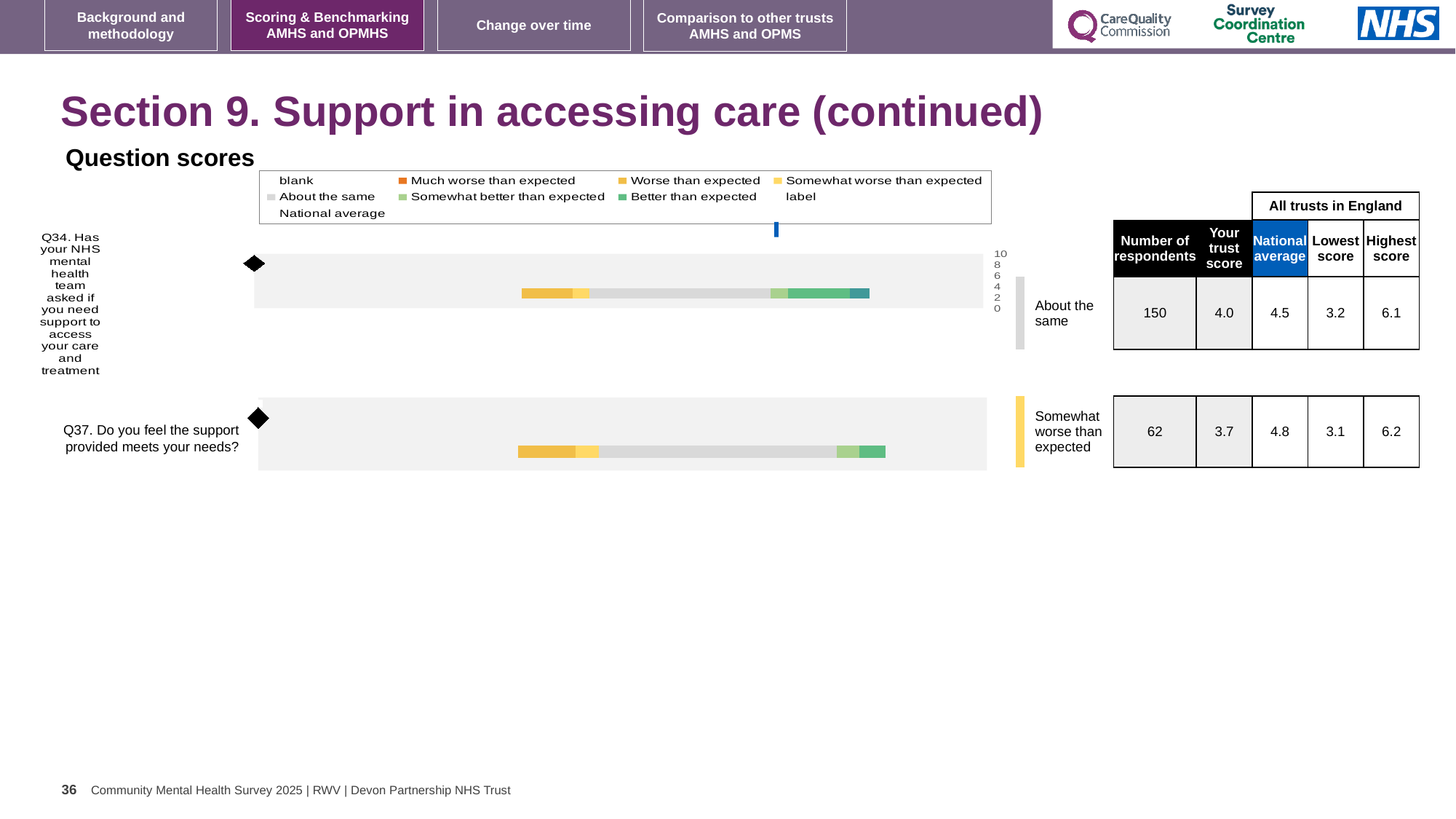
What benchmark category is shown for Q37? Somewhat worse than expected What benchmark category is shown for Q34? About the same What is the lowest score among all trusts in England for Q34? 3.2 Which question has the higher trust score, Q34 or Q37? Q34 What is the highest score among all trusts in England for Q37? 6.2 What is the difference between the national average and the trust score for Q34? 0.5 What kind of chart is used to show the question scores on this slide? bar chart How many questions are plotted in the question scores chart? 2 What is the trust score for Q37 (Do you feel the support provided meets your needs?)? 3.7 What is the number of respondents for Q34 in the question scores table? 150 What is the national average score for Q34? 4.5 Which legend entry is shown in dark green in the question scores chart? Better than expected